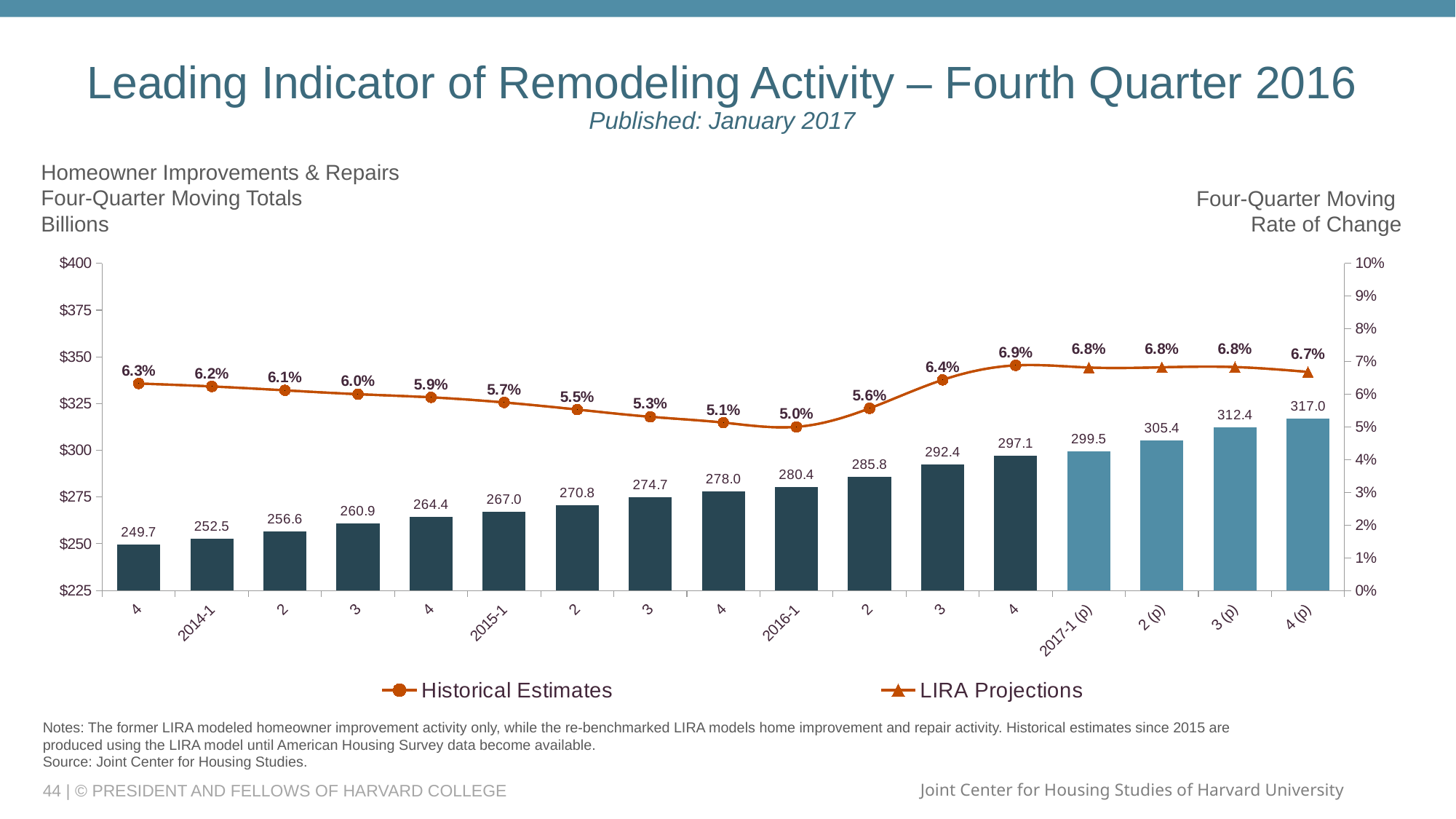
Do the four-quarter moving totals rise or fall from left to right across the chart? rise Which quarter has the lowest four-quarter moving rate of change? 2016-1, 5.0% Which quarter has the highest four-quarter moving total? 4 (p) (2017), 317.0 What is the difference between the four-quarter moving total for 4 (p) of 2017 (317.0) and the first bar, 2013 quarter 4 (249.7)? 67.3 What is the four-quarter moving rate of change for 2016-1? 5.0% How many bars (quarters) are plotted on the chart? 17 How many series does the legend list? 2 Is the four-quarter moving total for 2014-1 greater or less than $275? less Which quarter has the highest four-quarter moving rate of change? 2016 quarter 4, 6.9% What is the projected four-quarter moving total for 4 (p) of 2017? 317.0 Which is larger, the rate of change for 2014-1 or for 2015-1? 2014-1 (6.2%) What is the four-quarter moving total (in billions) for 2016-1? 280.4